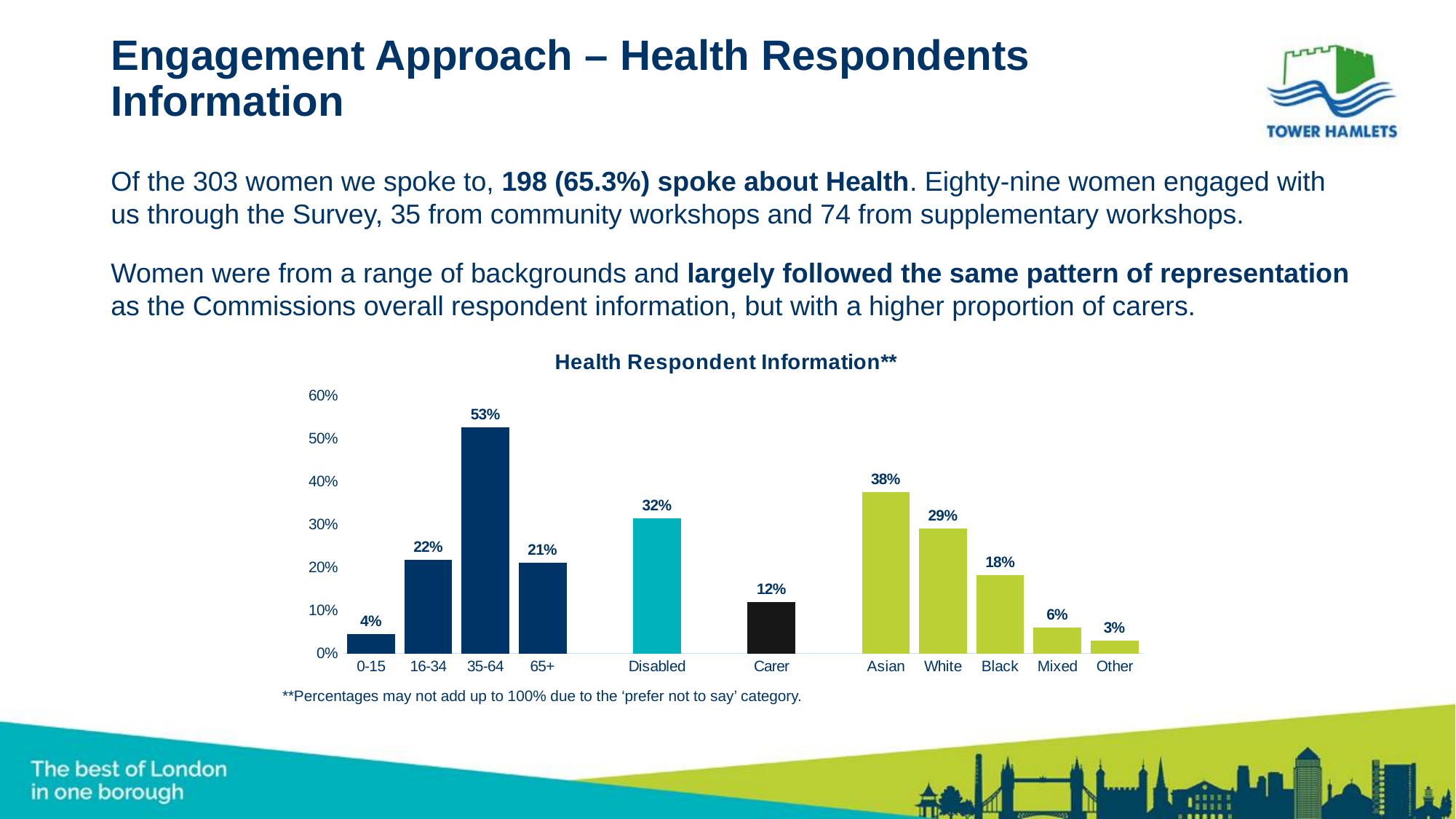
What is the value shown for Carer? 12% How many categories are shown on the x axis of the chart? 11 What percentage of health respondents were White? 29% What is the value for the 35-64 age group in the Health Respondent Information chart? 53% Which category has the highest value in the chart? 35-64 What percentage of health respondents were Disabled? 32% What type of chart is shown on the slide? Bar chart Which category has the lowest value in the chart? Other Which is larger, the value for 16-34 or the value for 65+? 16-34 What is the difference between the Asian and Black values? 20% Is the value for Disabled greater or less than 30%? greater What is the title of the chart? Health Respondent Information**